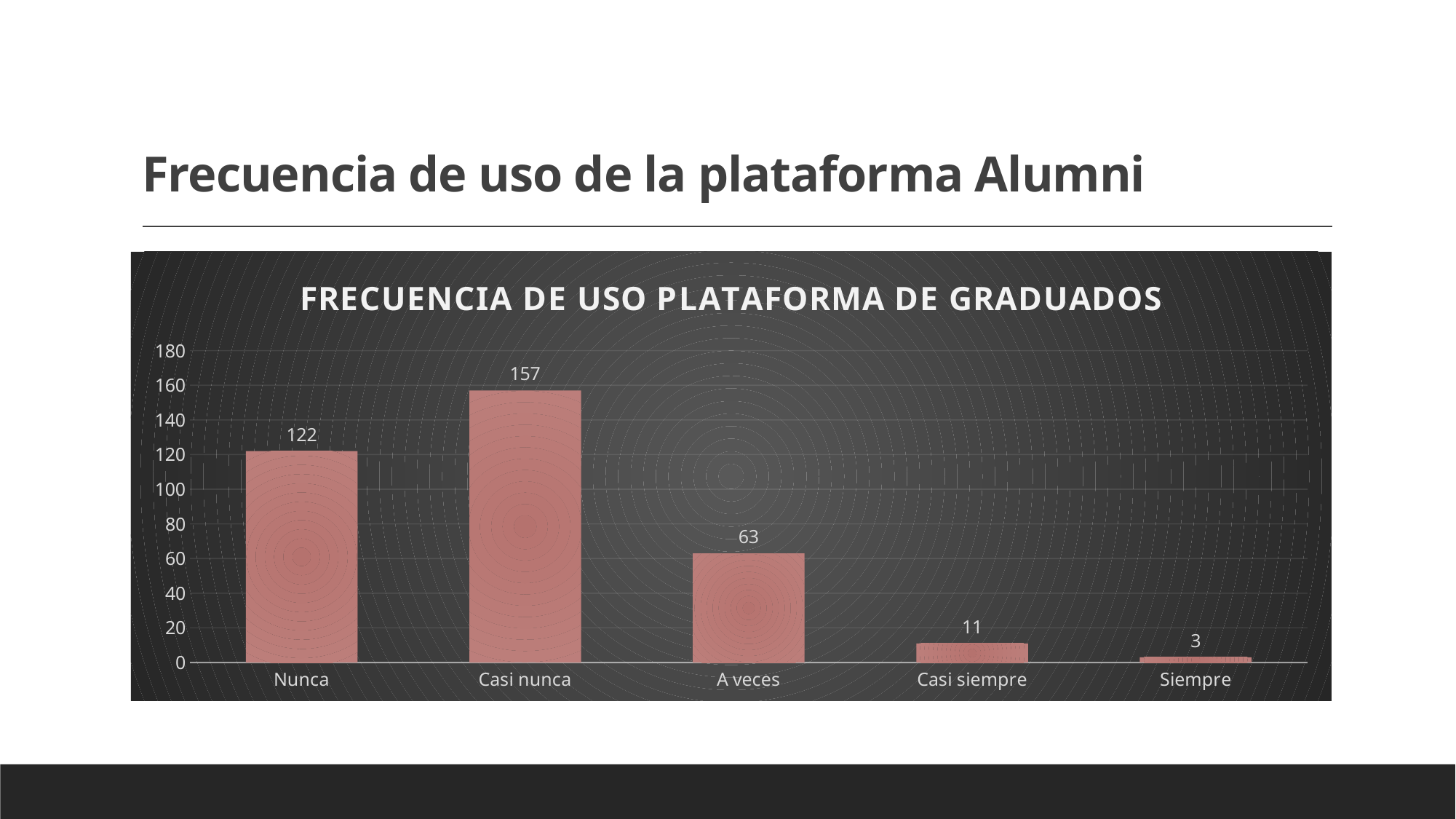
What is the value for Casi siempre? 11 What is the value for Siempre? 3 What kind of chart is shown on the slide? Bar chart How many categories are shown on the x axis? 5 What is the value for Nunca? 122 Which category has the highest value? Casi nunca Which is larger, the value for A veces or the value for Casi siempre? A veces What is the value for Casi nunca? 157 What is the difference between the values for Casi nunca and Nunca? 35 What is the value for A veces? 63 Which category has the lowest value? Siempre What is the title of the chart? FRECUENCIA DE USO PLATAFORMA DE GRADUADOS